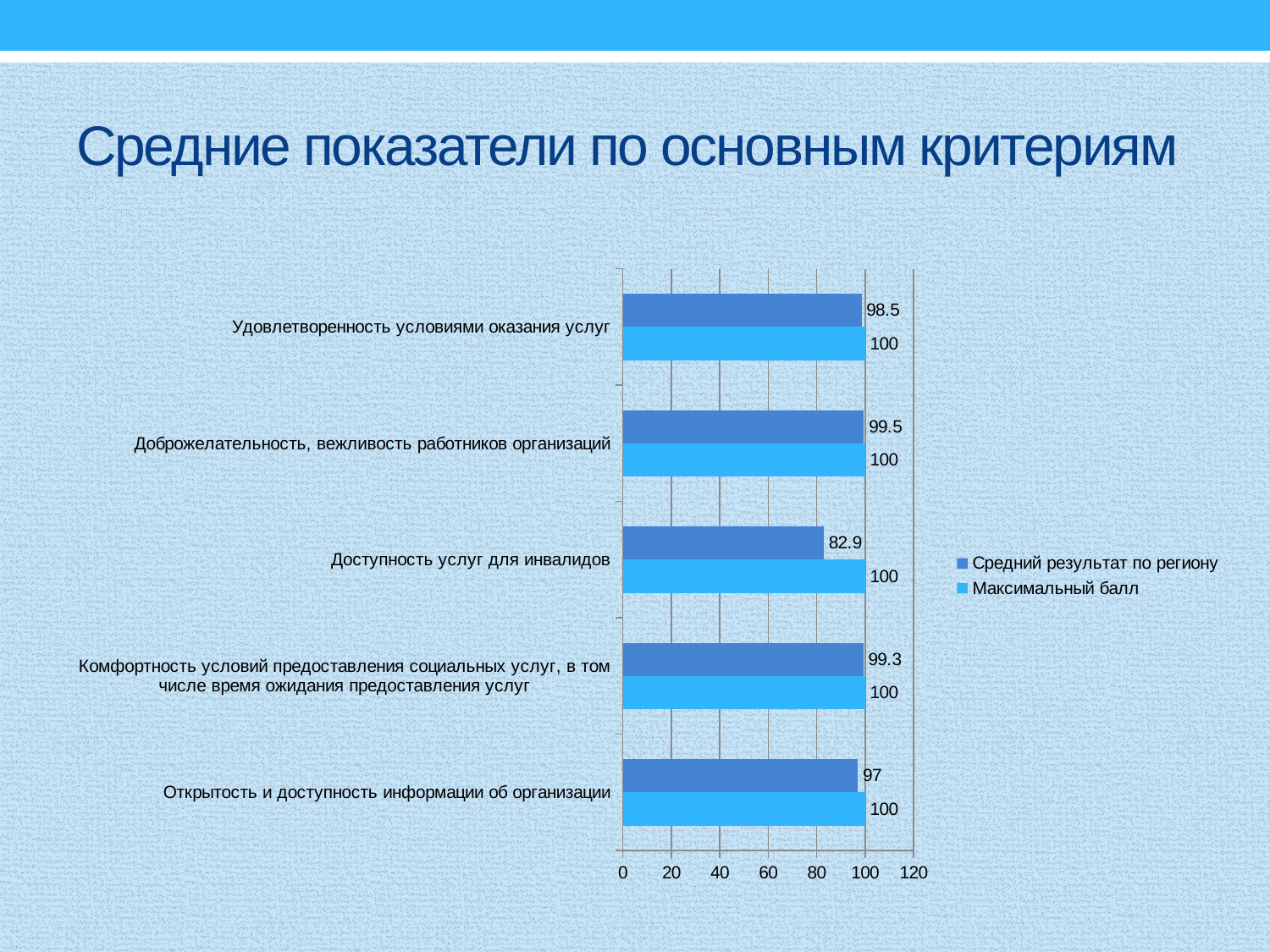
What is the title of the slide? Средние показатели по основным критериям What is the value of "Максимальный балл" for "Комфортность условий предоставления социальных услуг, в том числе время ожидания предоставления услуг"? 100 What is the value of "Средний результат по региону" for "Открытость и доступность информации об организации"? 97 What kind of chart is shown on the slide? Bar chart Which category has the lowest value for "Средний результат по региону"? Доступность услуг для инвалидов What is the value of "Средний результат по региону" for "Доступность услуг для инвалидов"? 82.9 What is the difference between "Максимальный балл" and "Средний результат по региону" for "Доступность услуг для инвалидов"? 17.1 Which is larger: "Средний результат по региону" for "Доброжелательность, вежливость работников организаций" or for "Открытость и доступность информации об организации"? Доброжелательность, вежливость работников организаций What is the value of "Средний результат по региону" for "Удовлетворенность условиями оказания услуг"? 98.5 How many series does the legend list? 2 How many categories are shown on the chart? 5 Which category has the highest value for "Средний результат по региону"? Доброжелательность, вежливость работников организаций